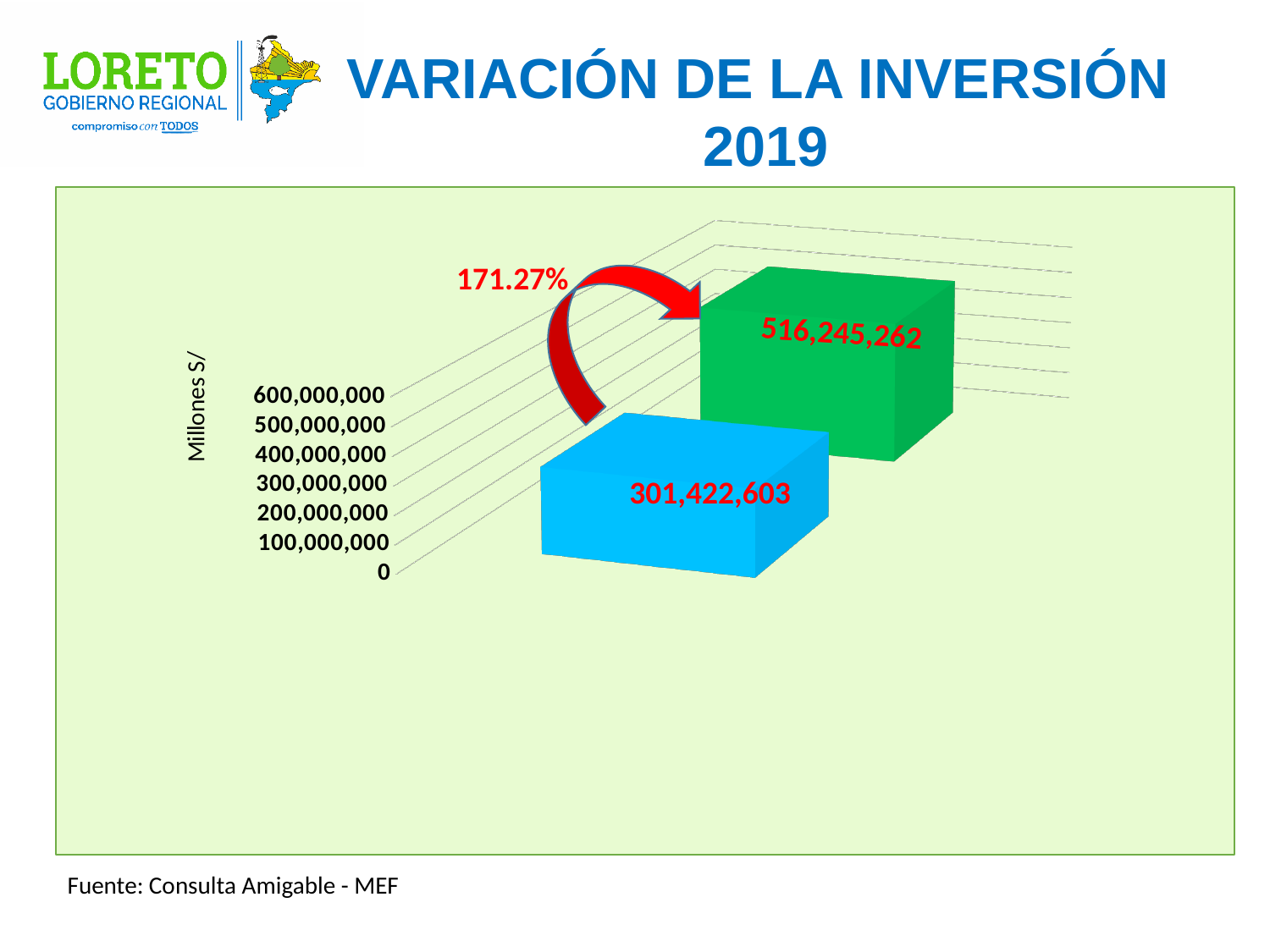
What value is printed on the green bar? 516,245,262 Is the value of the blue bar greater or less than 400,000,000? less What kind of chart is shown on the slide? bar chart Is the value of the green bar greater or less than 500,000,000? greater What is the label on the vertical axis of the chart? Millones S/ What value is printed on the blue bar? 301,422,603 How many bars are plotted in the chart? 2 What percentage is printed next to the red arrow in the chart? 171.27% Which bar has the lower value, the blue one or the green one? the blue bar Which bar has the higher value, the blue one or the green one? the green bar What is the difference between the green bar's value and the blue bar's value? 214,822,659